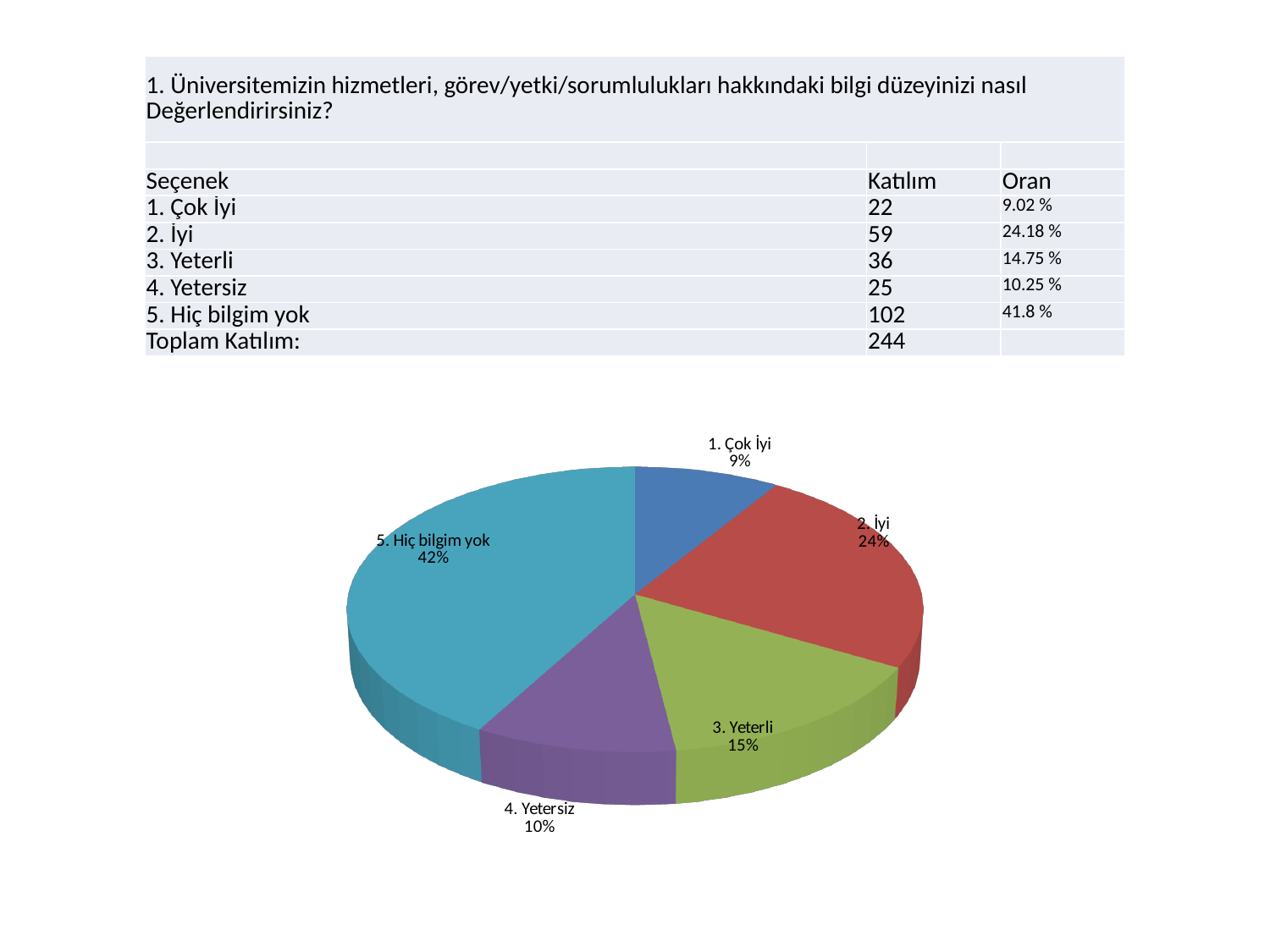
What share of the pie does the slice "4. Yetersiz" represent? 10% What share of the pie does the slice "1. Çok İyi" represent? 9% What colour is the "5. Hiç bilgim yok" slice in the pie chart? teal What share of the pie does the slice "5. Hiç bilgim yok" represent? 42% How many slices does the pie chart have? 5 Which slice is larger in the pie chart, "2. İyi" or "3. Yeterli"? 2. İyi Which slice of the pie chart is the smallest? 1. Çok İyi What is the difference in percentage points between the "5. Hiç bilgim yok" slice and the "2. İyi" slice? 18% Which slice of the pie chart is the largest? 5. Hiç bilgim yok What kind of chart is shown on the slide? pie chart